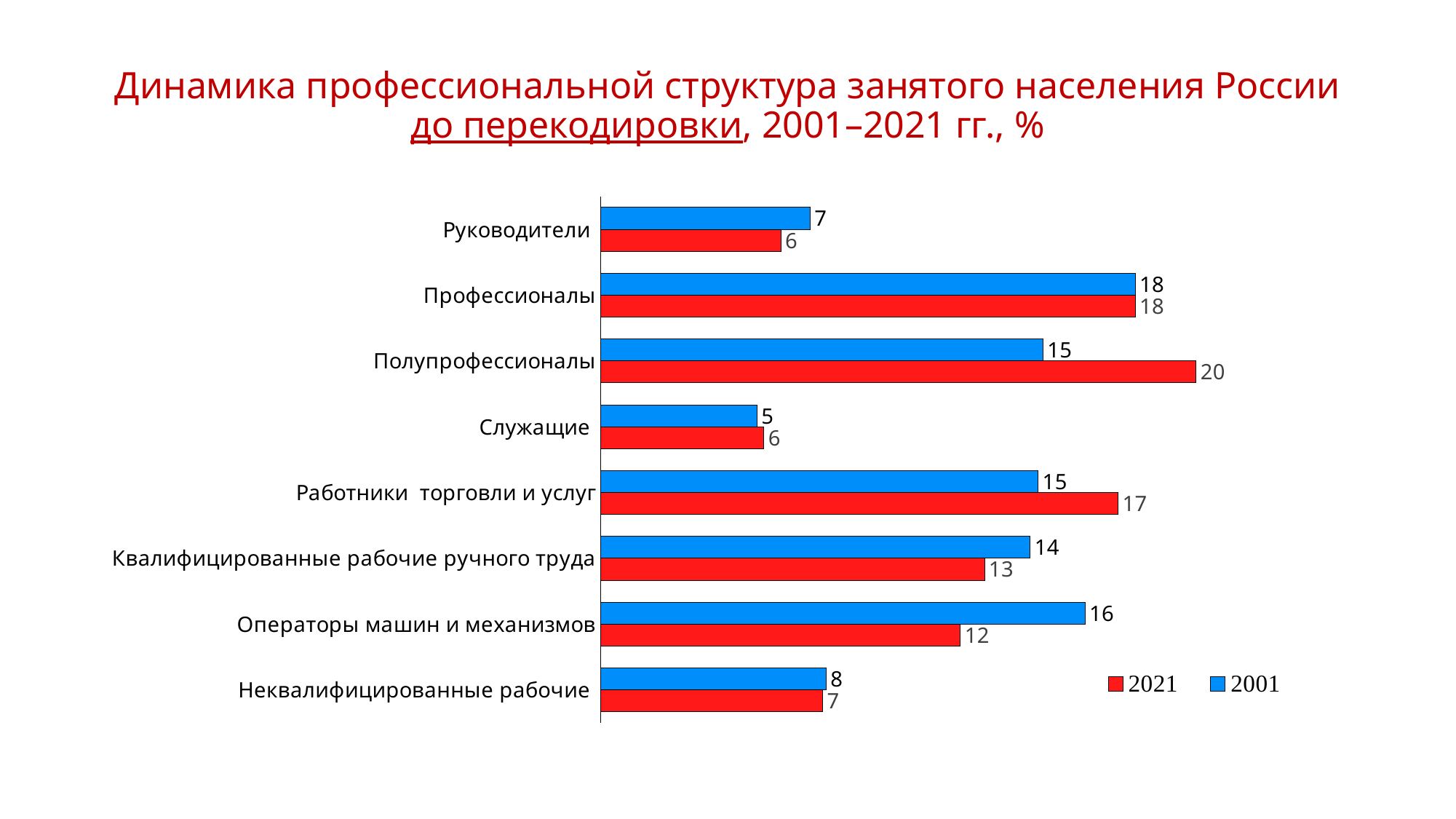
How many series does the legend list? 2 How many categories are shown on the chart? 8 What is the value for Служащие in 2001? 5 What is the value for Работники торговли и услуг in 2021? 17 Which is larger for Квалифицированные рабочие ручного труда: the 2001 value or the 2021 value? 2001 Which colour represents the 2021 series? Red Which category has the highest value in 2021? Полупрофессионалы What is the difference between the 2001 and 2021 values for Операторы машин и механизмов? 4 What kind of chart is shown on the slide? Bar chart Which category has the lowest value in 2001? Служащие What is the value for Операторы машин и механизмов in 2001? 16 What is the value for Полупрофессионалы in 2021? 20